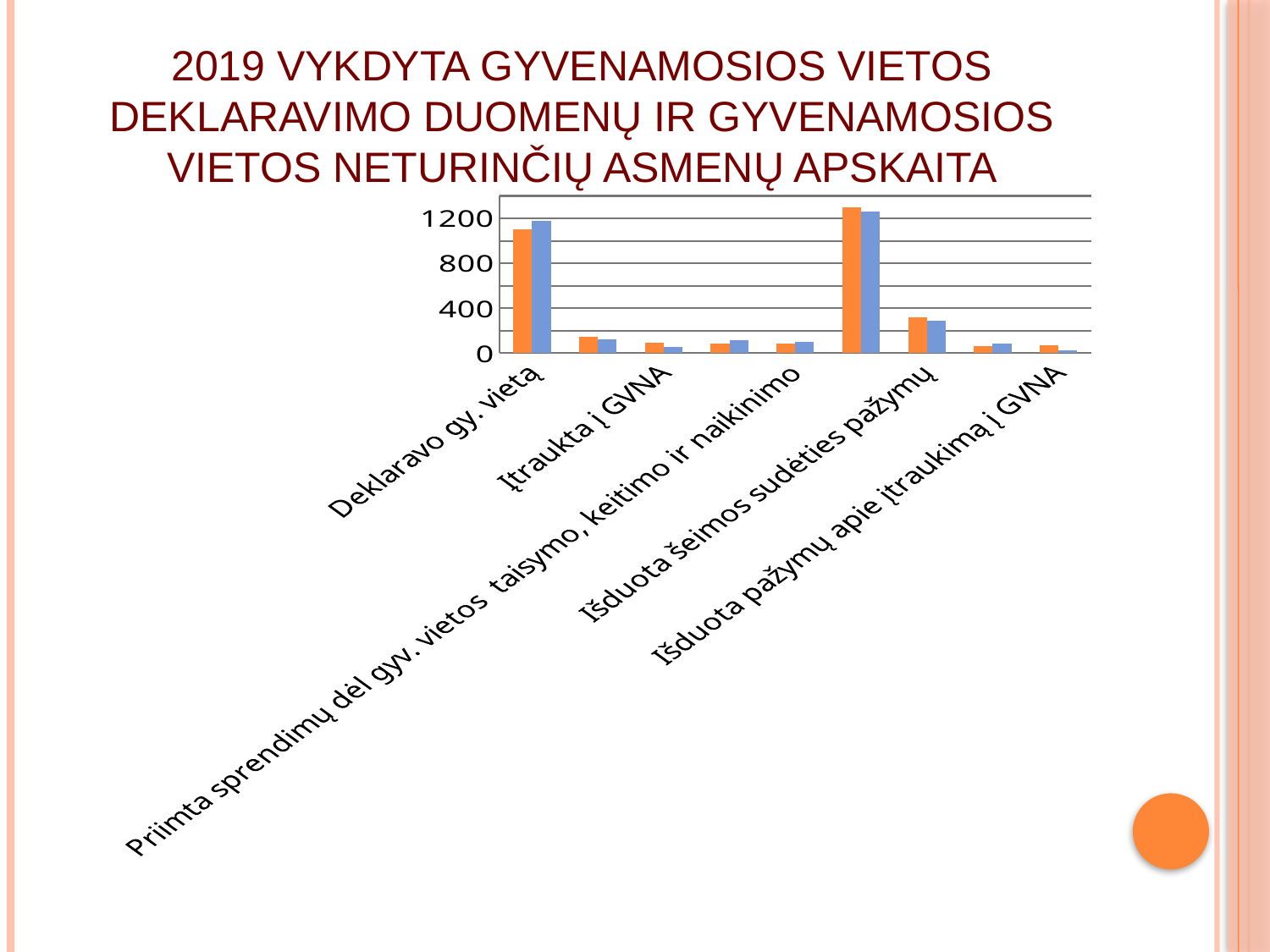
Is the orange bar for 'Deklaravo gy. vietą' greater or less than 800? greater What kind of chart is shown on the slide? bar chart Is the tallest orange bar in the chart greater or less than 1200? greater How many groups of bars (categories) are plotted in the chart? 9 What is the highest value shown on the vertical axis of the chart? 1200 For 'Deklaravo gy. vietą', which bar is taller, the orange one or the blue one? blue How many data series (bar colours) are plotted in the chart? 2 What is the first category label on the horizontal axis of the chart? Deklaravo gy. vietą Is the orange bar for 'Įtraukta į GVNA' greater or less than 400? less